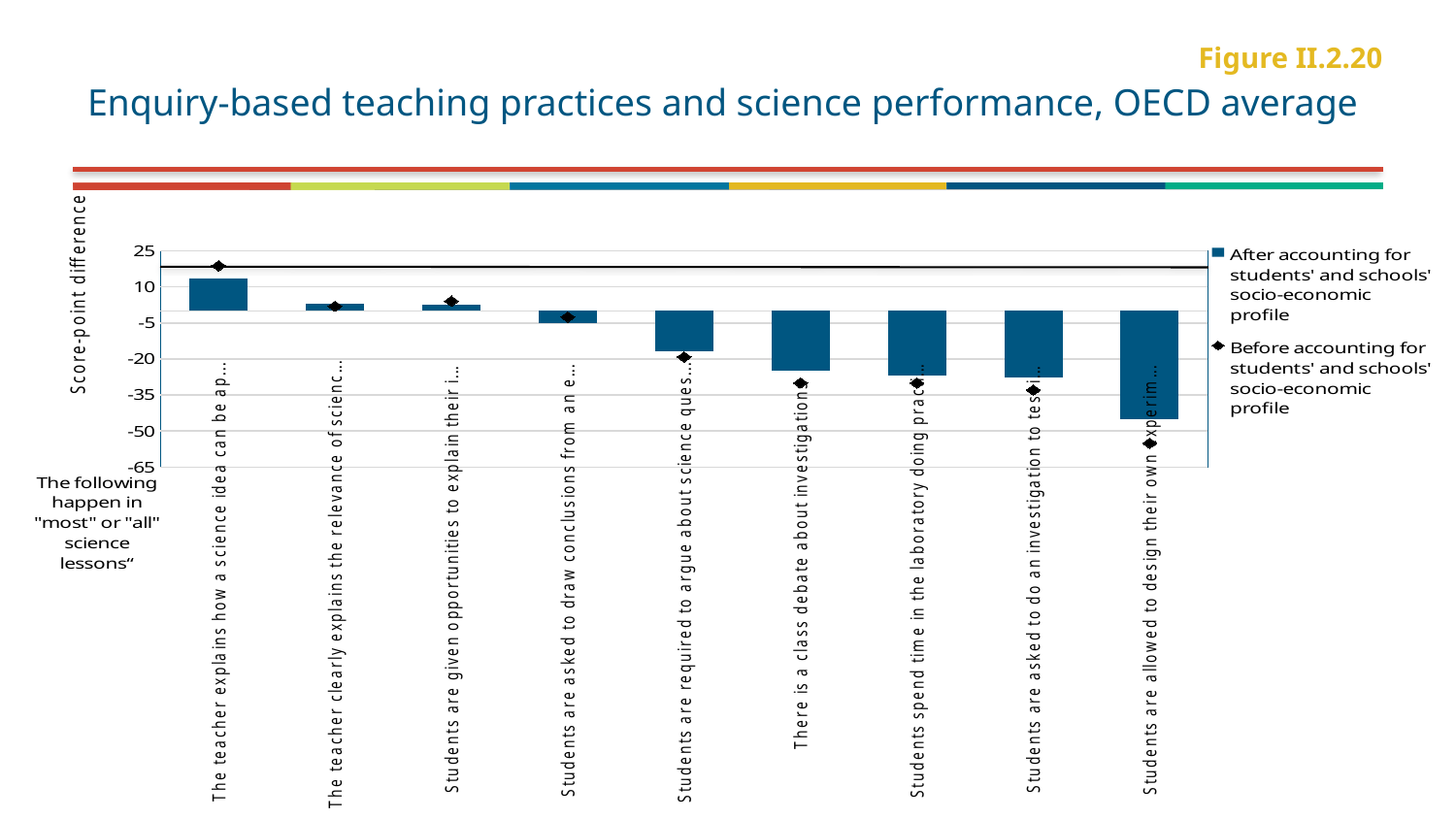
Is the 'After accounting' bar for 'Students are allowed to design their own experim...' greater or less than -35? less Is the 'Before accounting' diamond for 'Students are allowed to design their own experim...' greater or less than -50? less Is the 'After accounting' bar for 'The teacher explains how a science idea can be ap...' greater or less than -5? greater Which category has the lowest score-point difference after accounting for students' and schools' socio-economic profile? Students are allowed to design their own experim... Which is larger: the 'After accounting' bar for 'There is a class debate about investigation...' or for 'Students are asked to draw conclusions from an e...'? Students are asked to draw conclusions from an e... Which category has the highest score-point difference after accounting for students' and schools' socio-economic profile? The teacher explains how a science idea can be ap... How many teaching practices (categories) are plotted along the x axis? 9 Do the bar values rise or fall moving from left to right along the x axis? fall What kind of chart is shown on the slide? bar chart How many series does the legend list? 2 What is the title of the chart? Enquiry-based teaching practices and science performance, OECD average